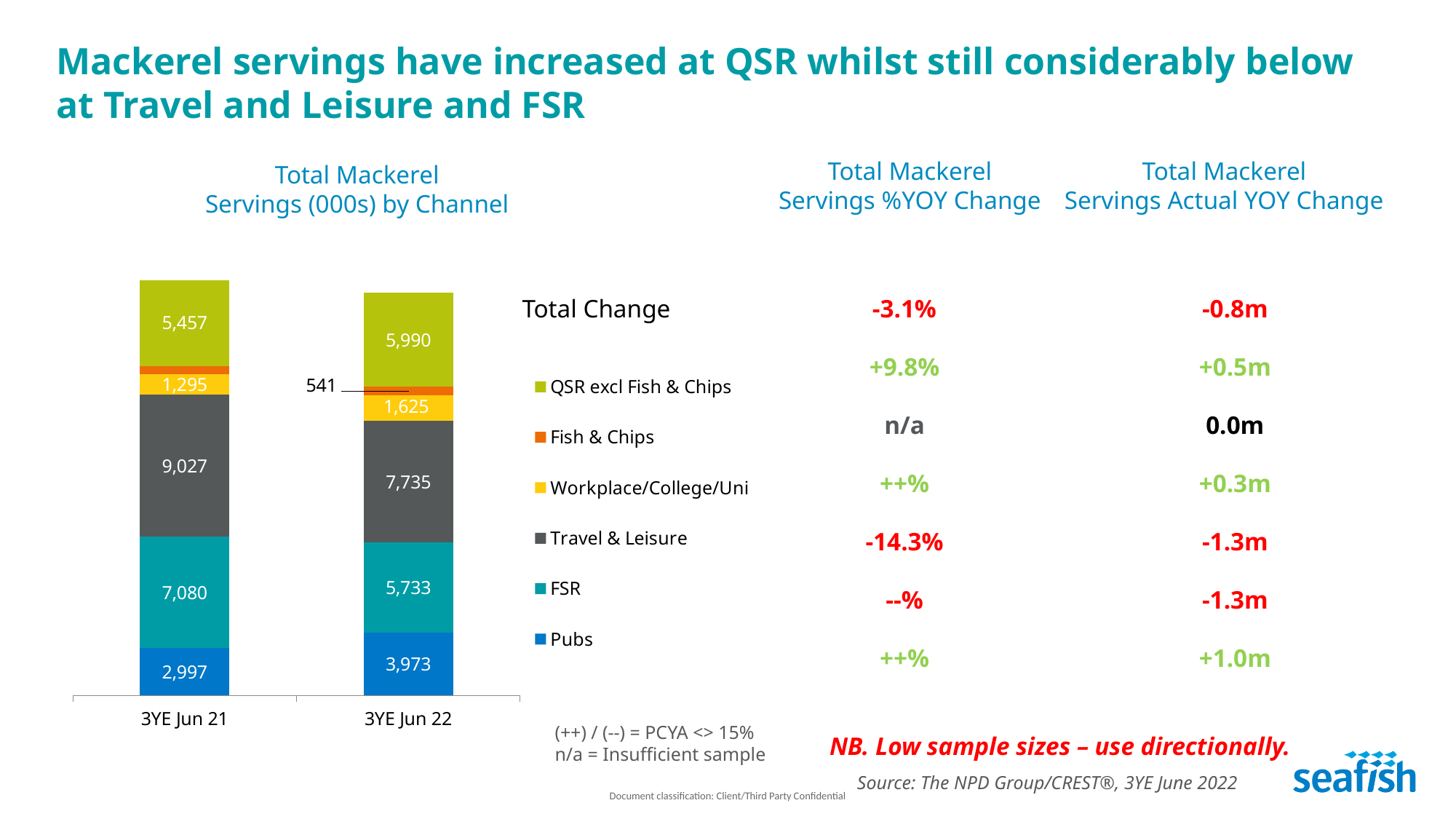
What kind of chart is the Total Mackerel Servings (000s) by Channel chart? Stacked bar chart How many series does the legend of the Total Mackerel Servings (000s) by Channel chart list? 6 Which channel has the largest segment in the 3YE Jun 22 bar of the Total Mackerel Servings (000s) by Channel chart? Travel & Leisure What is the value for Pubs in 3YE Jun 22 on the Total Mackerel Servings (000s) by Channel chart? 3,973 What is the value for Travel & Leisure in 3YE Jun 21 on the Total Mackerel Servings (000s) by Channel chart? 9,027 Is the FSR value larger in 3YE Jun 21 or 3YE Jun 22 on the Total Mackerel Servings (000s) by Channel chart? 3YE Jun 21 By how much did the Travel & Leisure value fall from 3YE Jun 21 to 3YE Jun 22 on the Total Mackerel Servings (000s) by Channel chart? 1,292 What is the total of the 3YE Jun 22 stacked bar on the Total Mackerel Servings (000s) by Channel chart? 25,597 What is the value for QSR excl Fish & Chips in 3YE Jun 22 on the Total Mackerel Servings (000s) by Channel chart? 5,990 Which labelled channel has the smallest segment in the 3YE Jun 22 bar of the Total Mackerel Servings (000s) by Channel chart? Fish & Chips How many periods are shown on the x axis of the Total Mackerel Servings (000s) by Channel chart? 2 What is the value for Fish & Chips in 3YE Jun 22 on the Total Mackerel Servings (000s) by Channel chart? 541